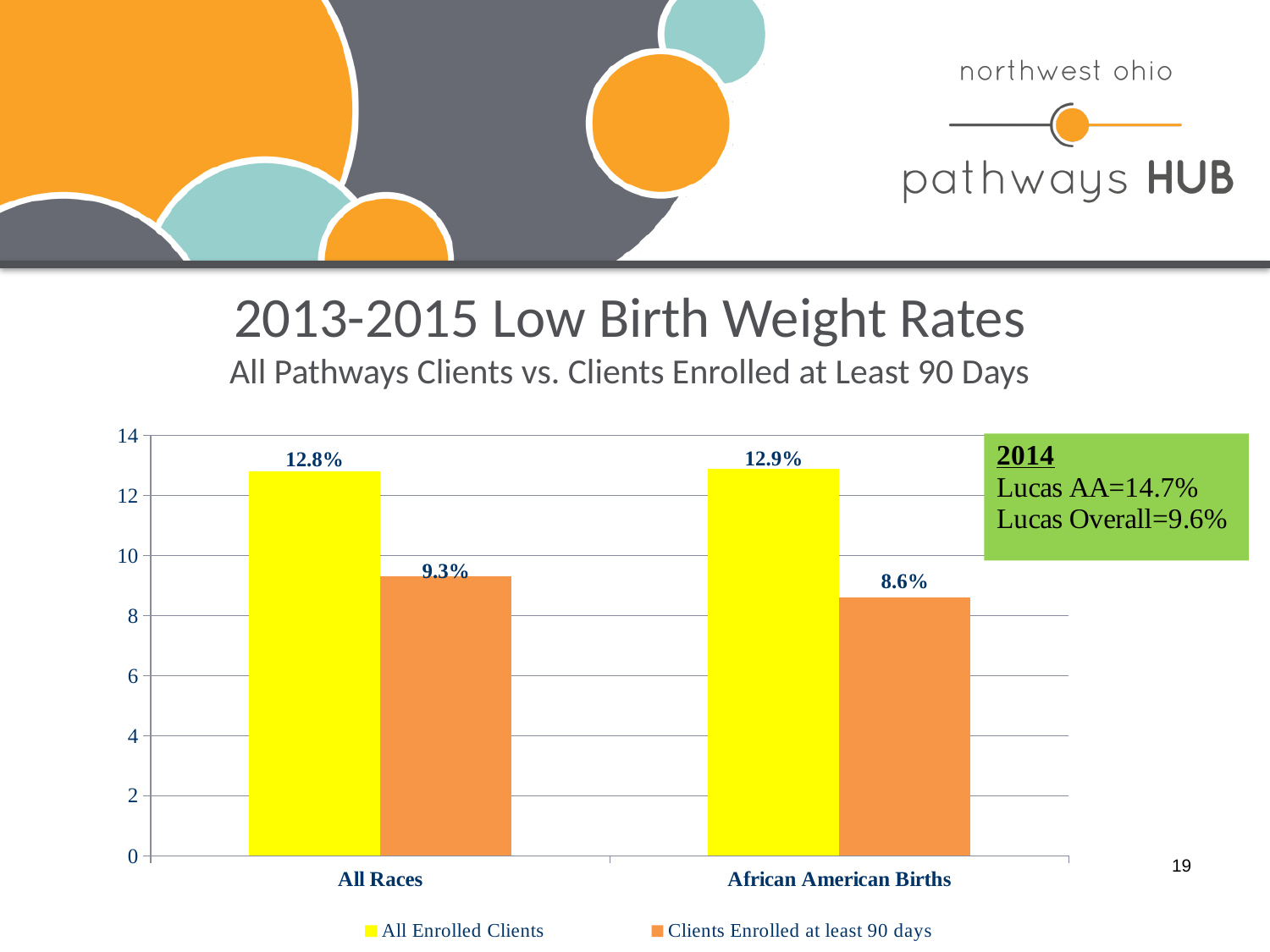
Which bar has the lowest value on the chart? Clients Enrolled at least 90 days, African American Births What is the low birth weight rate for Clients Enrolled at least 90 days in the African American Births category? 8.6% How many series does the legend list? 2 What is the difference between All Enrolled Clients and Clients Enrolled at least 90 days in the African American Births category? 4.3% What is the low birth weight rate for All Enrolled Clients in the All Races category? 12.8% What is the value for Clients Enrolled at least 90 days in the All Races category? 9.3% What kind of chart is shown on the slide? Bar chart Is the value for Clients Enrolled at least 90 days in the All Races category greater or less than 10? less Which is larger: Clients Enrolled at least 90 days for All Races or for African American Births? All Races How many categories are shown on the x axis? 2 What is the difference between All Enrolled Clients and Clients Enrolled at least 90 days in the All Races category? 3.5% What is the value for All Enrolled Clients in the African American Births category? 12.9%